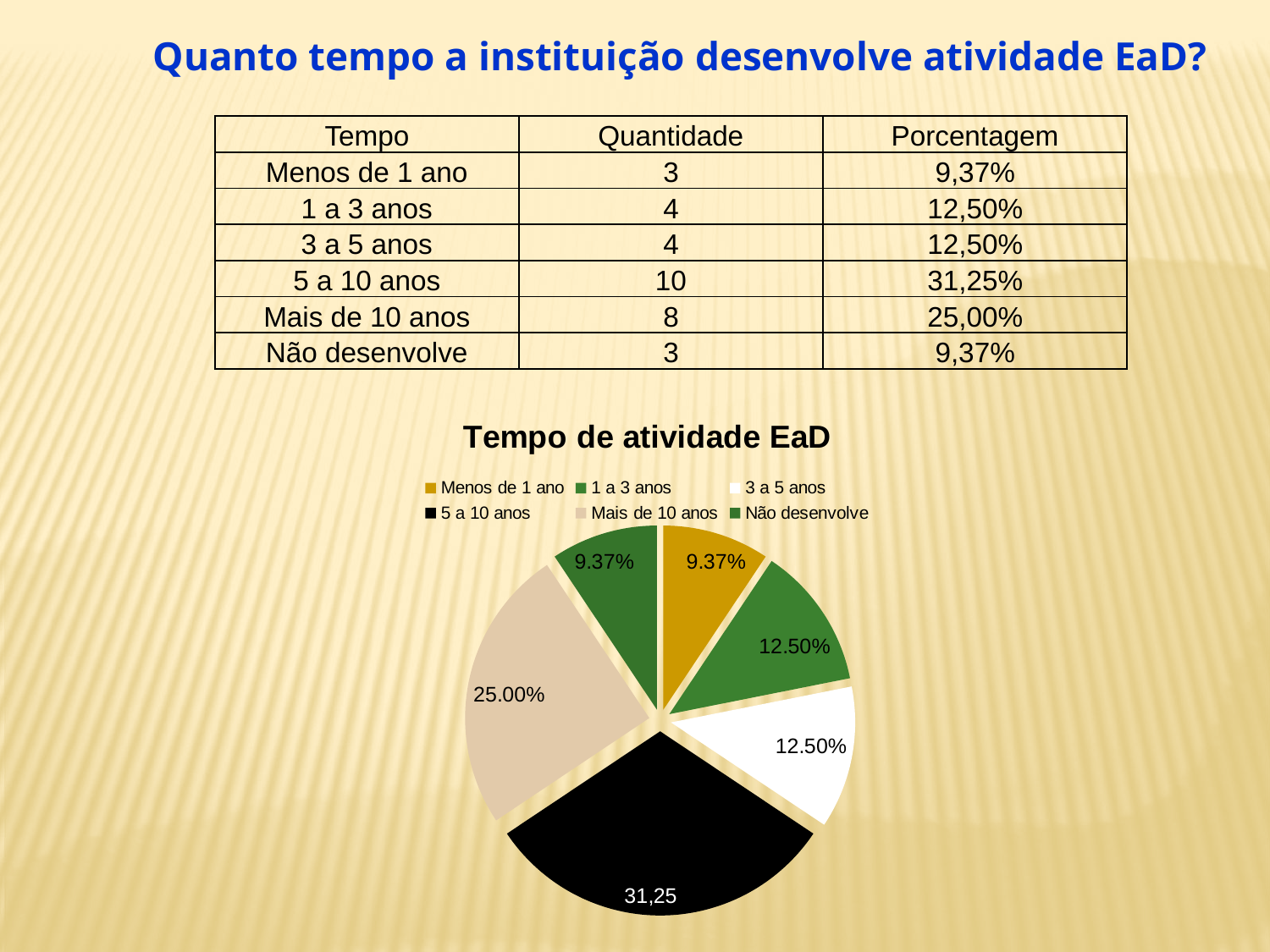
How many slices does the pie chart have? 6 What kind of chart is shown on the slide? pie chart How many entries does the chart legend list? 6 What is the data label shown for the '5 a 10 anos' slice? 31,25 What is the data label shown for the 'Menos de 1 ano' slice? 9.37% Which slice is larger, 'Mais de 10 anos' or '3 a 5 anos'? Mais de 10 anos What is the data label shown for the '1 a 3 anos' slice? 12.50% What is the difference between the 'Mais de 10 anos' slice and the '3 a 5 anos' slice? 12.50% What is the data label shown for the 'Mais de 10 anos' slice? 25.00% Which category has the largest slice of the pie? 5 a 10 anos What is the title of the chart? Tempo de atividade EaD What colour is the '5 a 10 anos' slice in the pie chart? black